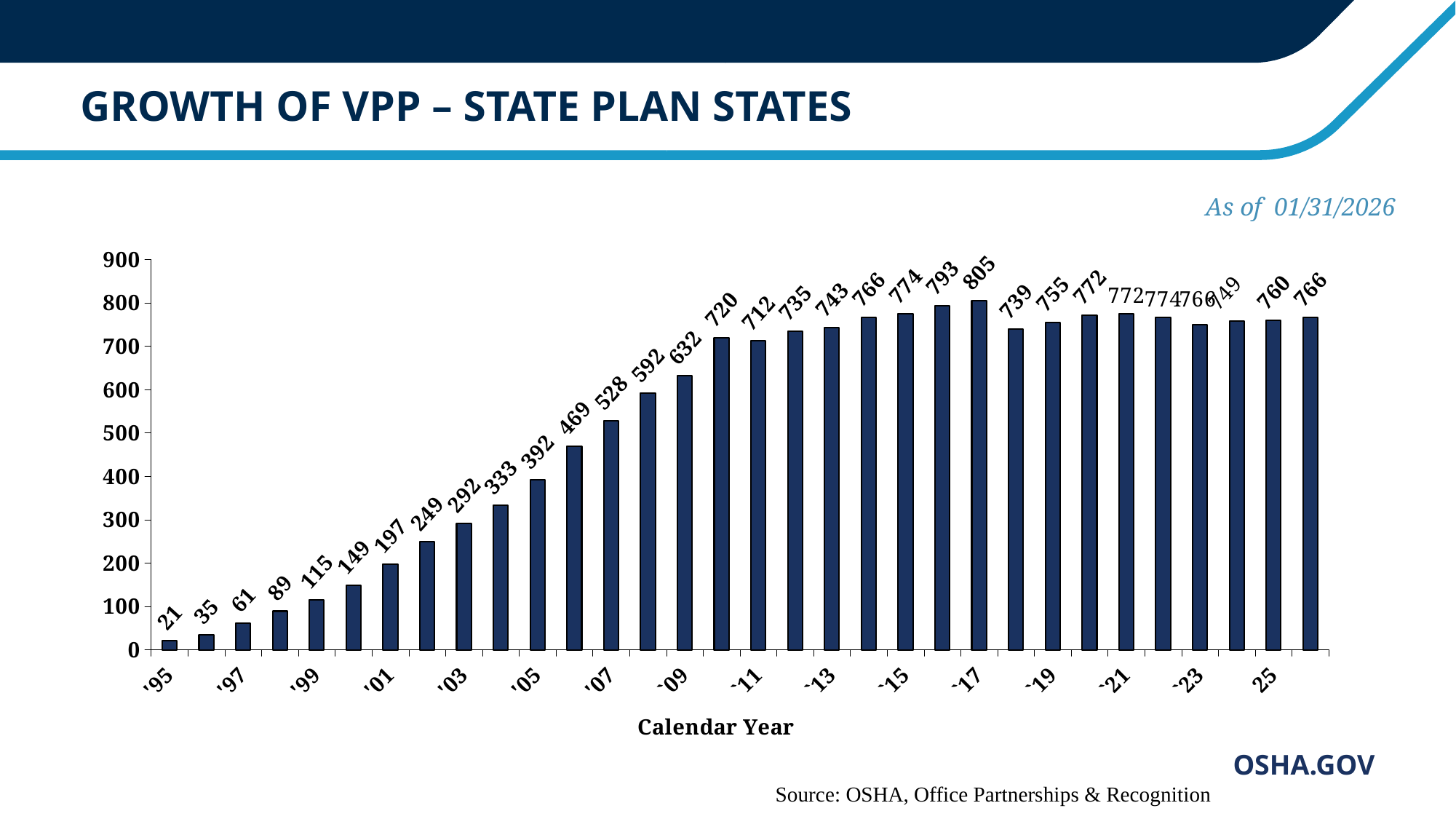
What type of chart is shown on the slide? bar chart What is the value for '19? 755 What is the value for '95? 21 What is the value for '13? 743 Is the value for '09 greater or less than 600? greater What is the value for '05? 392 Which is larger, the value for '10 or the value for '11? '10 What is the difference between the values for '17 and '18? 66 Which year has the lowest value? '95 Which year has the highest value? '17 What is the label of the x axis? Calendar Year What is the title of the chart? GROWTH OF VPP – STATE PLAN STATES